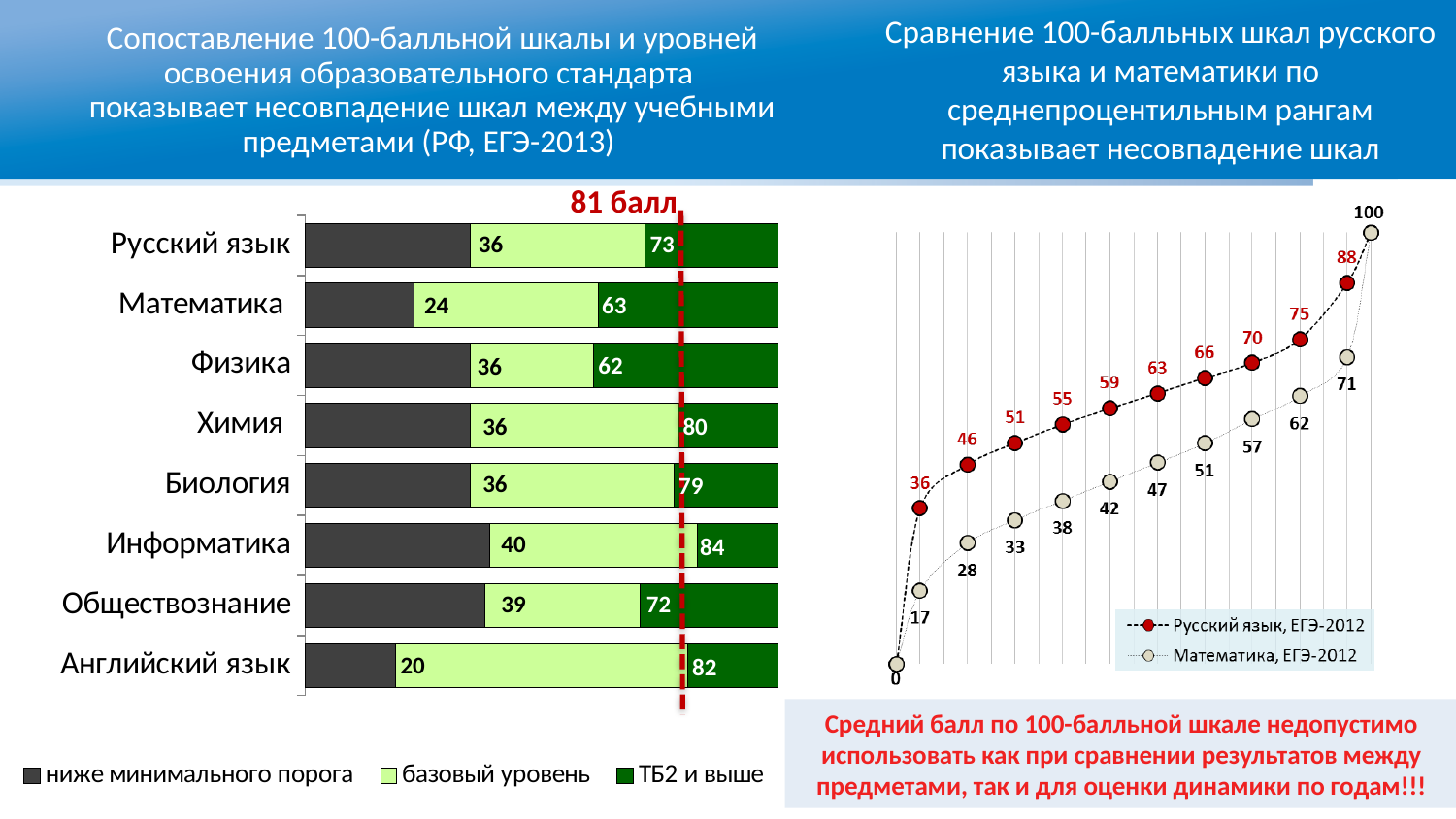
On the right chart, how many series does the legend list? 2 On the left chart, what is the difference between the two boundary values shown for Русский язык? 37 On the left chart, what is the upper boundary value shown for Информатика? 84 On the right chart, which series has the larger value at the second point: Русский язык, ЕГЭ-2012 (36) or Математика, ЕГЭ-2012 (17)? Русский язык, ЕГЭ-2012 On the left chart, which subject has the highest second boundary value? Информатика What type of chart is the left chart? Stacked bar chart On the left chart, which subject has the lowest first (minimum threshold) value? Английский язык On the left chart, what is the lower boundary value shown for Математика? 24 On the left chart, what value does the red dashed vertical line mark? 81 балл On the right chart, do the values of the Русский язык, ЕГЭ-2012 series rise or fall from left to right? Rise On the right chart, what is the second labelled value of the Математика, ЕГЭ-2012 series? 17 On the left chart, how many subjects are listed? 8